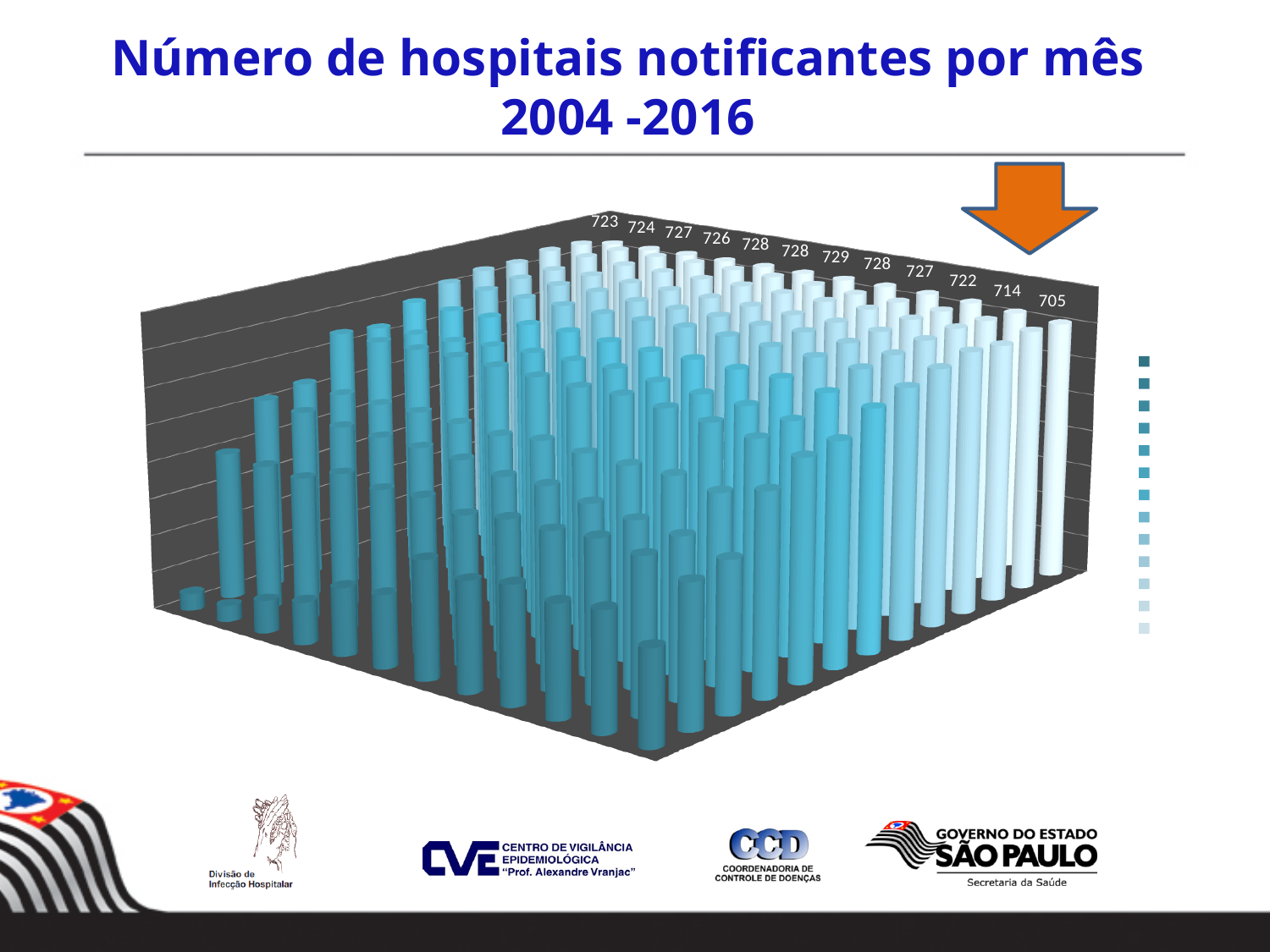
What is the lowest value among the data labels printed on the chart? 705 What is the highest value among the data labels printed on the chart? 729 What is the title of the chart on the slide? Número de hospitais notificantes por mês 2004 -2016 Which is larger, the first labeled value on the back row or the last labeled value on the back row? the first (723) What is the difference between the highest labeled value (729) and the lowest labeled value (705)? 24 What is the second data label shown on the back row of bars? 724 What colour is the arrow pointing down at the chart in the top right? orange What is the last data label shown on the back row of bars? 705 How many data labels are printed on the back row of the chart? 12 What kind of chart is shown on the slide? bar chart What is the first data label shown on the back row of bars? 723 Do the labeled values on the back row rise or fall over the last four labels (728, 727, 722, 714, 705)? fall